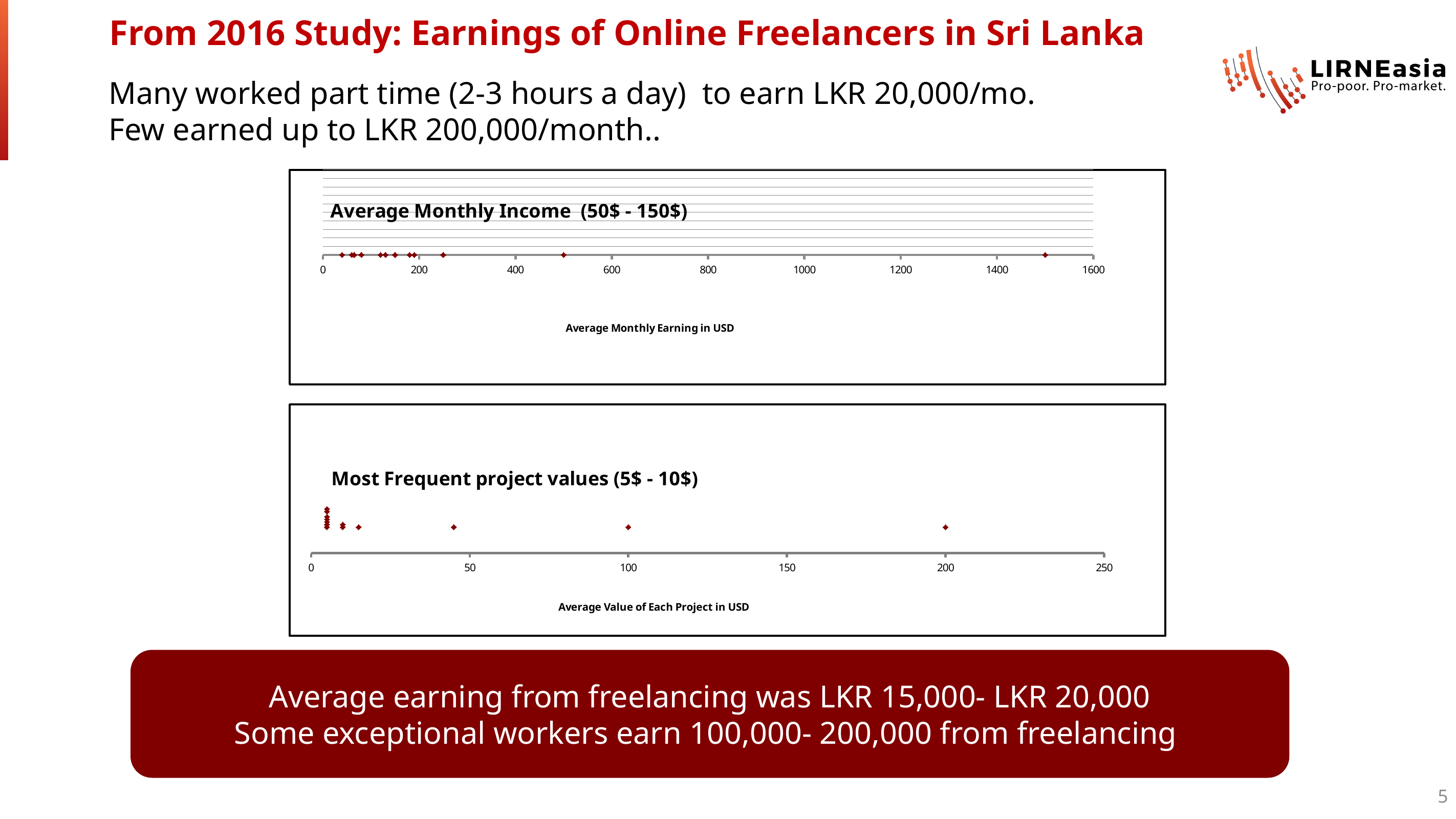
What is the x-axis title of the bottom chart? Average Value of Each Project in USD In the top chart, is the second-highest plotted monthly earning greater or less than 600? less In the top chart, is the rightmost (highest) plotted monthly earning greater or less than 1400? greater In the top chart, are most of the plotted monthly earnings greater or less than 400? less What kind of chart is the top chart titled 'Average Monthly Income (50$ - 150$)'? Scatter (dot) plot In the bottom chart, what is the maximum value shown on the x axis? 250 In the bottom chart, what is the highest plotted project value in USD? 200 In the top chart, what is the maximum value shown on the x axis? 1600 In the bottom chart, which is larger: the rightmost plotted point or the point at 100? The rightmost point (200) What is the x-axis title of the top chart? Average Monthly Earning in USD